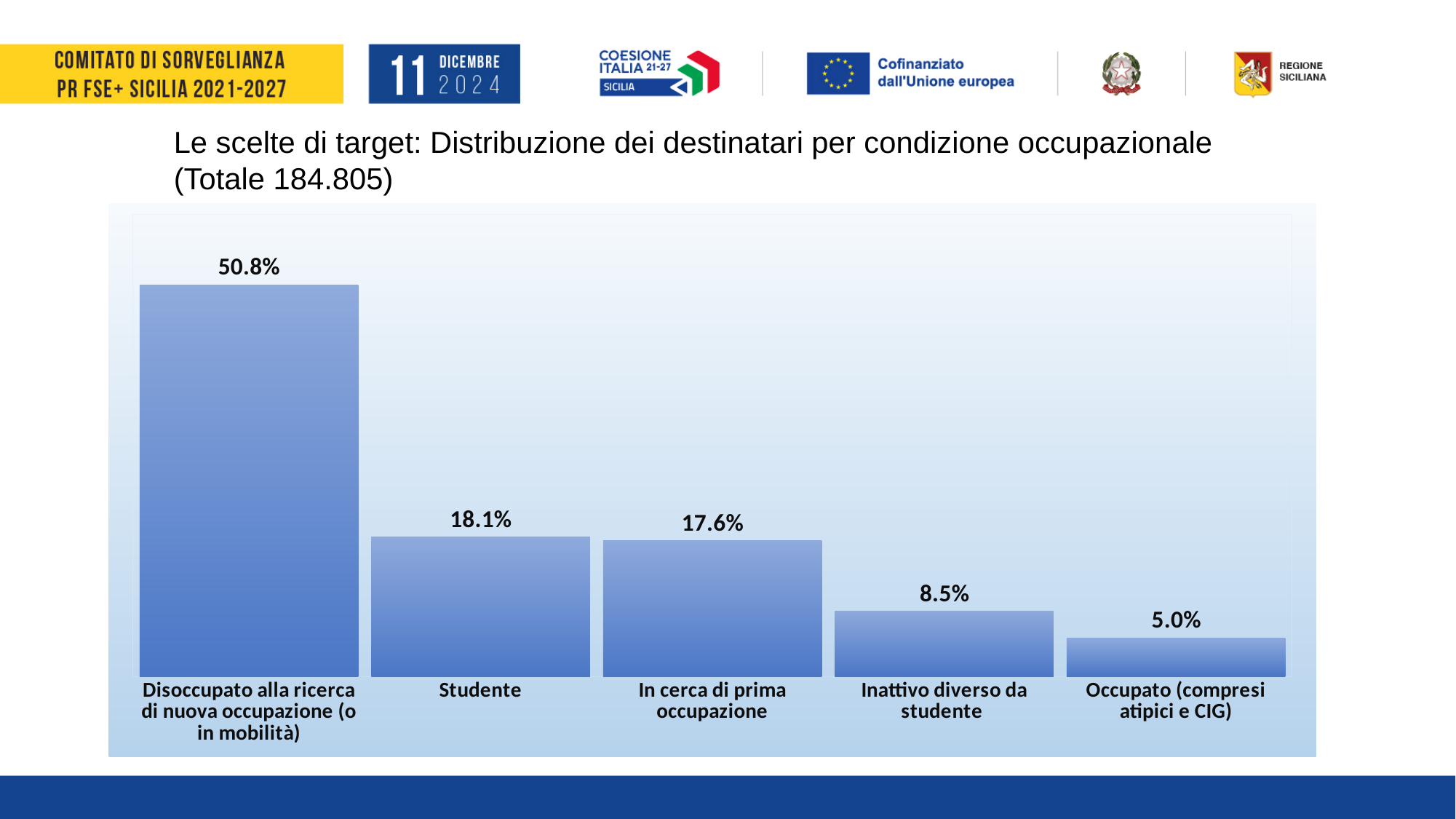
Which is larger, the value for Inattivo diverso da studente or the value for Occupato (compresi atipici e CIG)? Inattivo diverso da studente What is the value for Inattivo diverso da studente? 8.5% What total number of recipients is stated in the slide title? 184.805 What is the difference between the values for Disoccupato alla ricerca di nuova occupazione (o in mobilità) and Inattivo diverso da studente? 42.3% What is the value for In cerca di prima occupazione? 17.6% What is the value for Studente? 18.1% What kind of chart is shown on the slide? Bar chart How many categories are shown in the chart? 5 What is the difference between the values for Studente and In cerca di prima occupazione? 0.5% Which category has the highest value? Disoccupato alla ricerca di nuova occupazione (o in mobilità) Which category has the lowest value? Occupato (compresi atipici e CIG) What is the value for Occupato (compresi atipici e CIG)? 5.0%